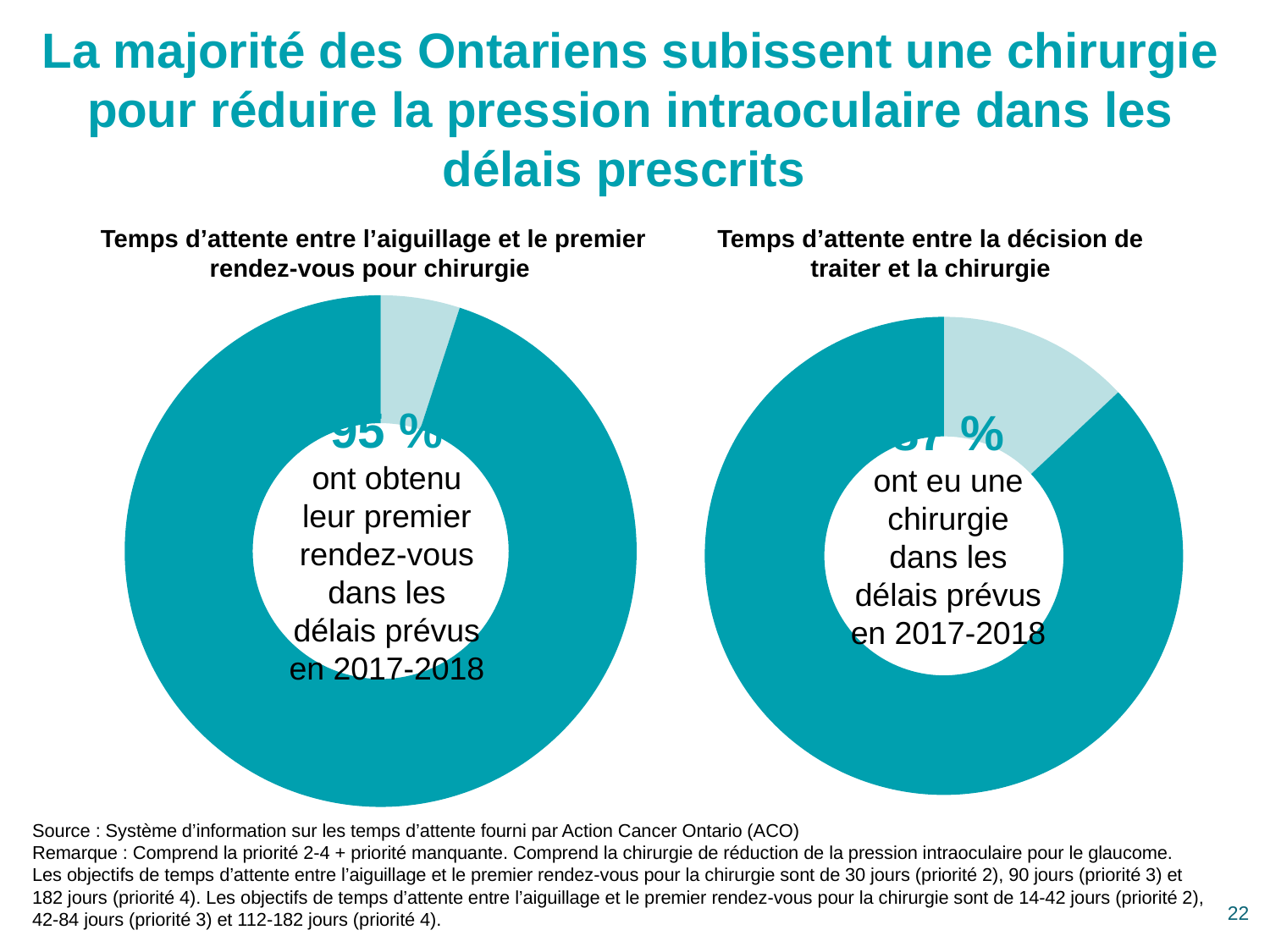
What is the title of the right chart? Temps d'attente entre la décision de traiter et la chirurgie How many slices does the left chart (Temps d'attente entre l'aiguillage et le premier rendez-vous pour chirurgie) have? 2 What kind of charts are shown on the slide? pie (donut) charts How many charts are on the slide? 2 In the left chart (Temps d'attente entre l'aiguillage et le premier rendez-vous pour chirurgie), what share of the pie does the dark teal slice represent? 95 % In the left chart (Temps d'attente entre l'aiguillage et le premier rendez-vous pour chirurgie), is the light slice larger or smaller than the dark slice? smaller Which chart has the larger dark teal slice, the left chart (aiguillage to premier rendez-vous) or the right chart (décision de traiter to chirurgie)? the left chart What is the title of the left chart? Temps d'attente entre l'aiguillage et le premier rendez-vous pour chirurgie In the left chart (Temps d'attente entre l'aiguillage et le premier rendez-vous pour chirurgie), what percentage of patients got their first appointment within the target time in 2017-2018? 95 % How many slices does the right chart (Temps d'attente entre la décision de traiter et la chirurgie) have? 2